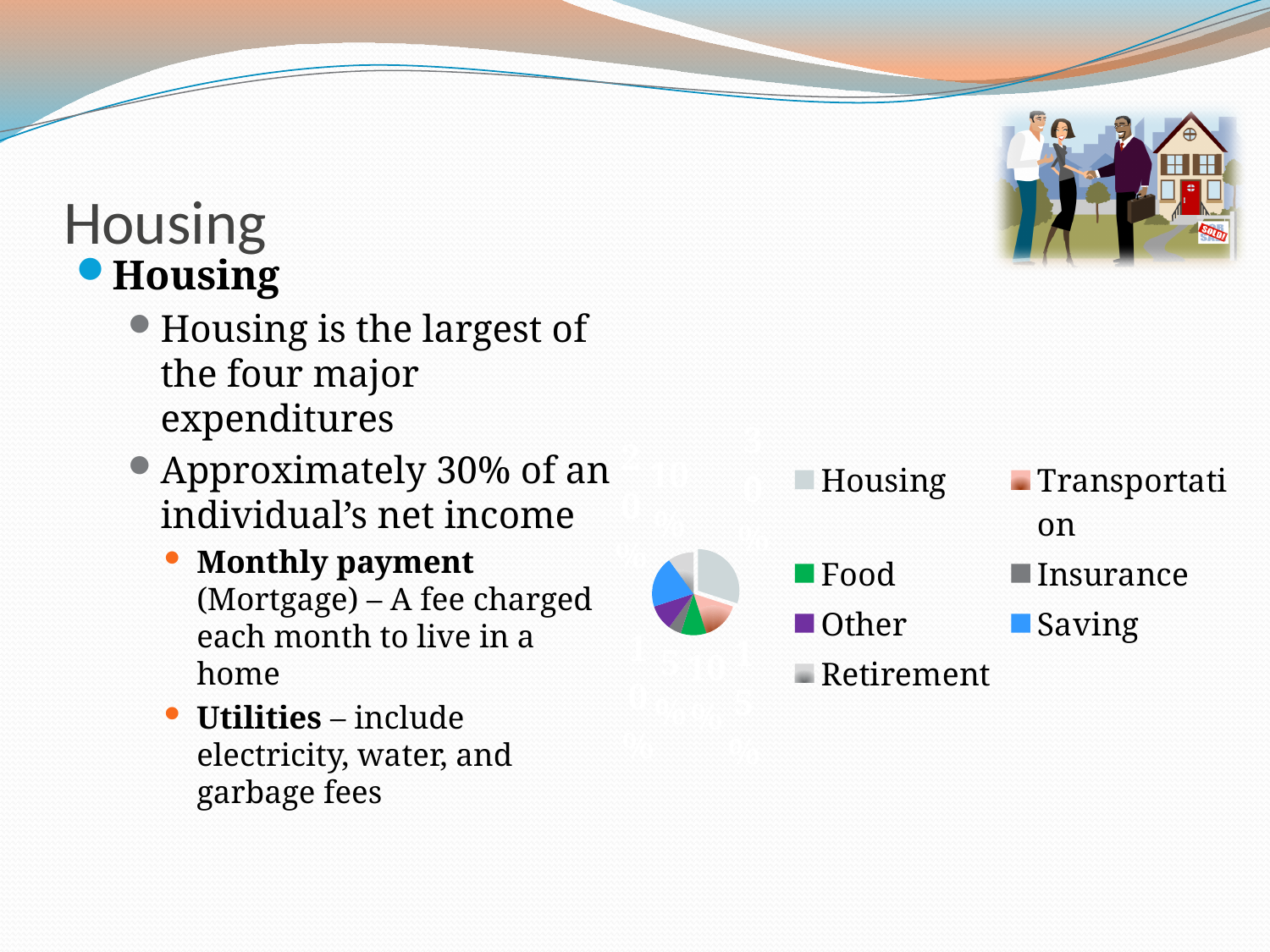
Which slice is larger in the pie chart, Housing or Food? Housing Which category has the largest slice in the pie chart? Housing Which category in the pie chart's legend is shown in green? Food How many categories does the pie chart's legend list? 7 Which slice is larger in the pie chart, Housing or Other? Housing What kind of chart is shown on the slide? pie chart How many slices does the pie chart have? 7 Which category in the pie chart's legend is shown in blue? Saving